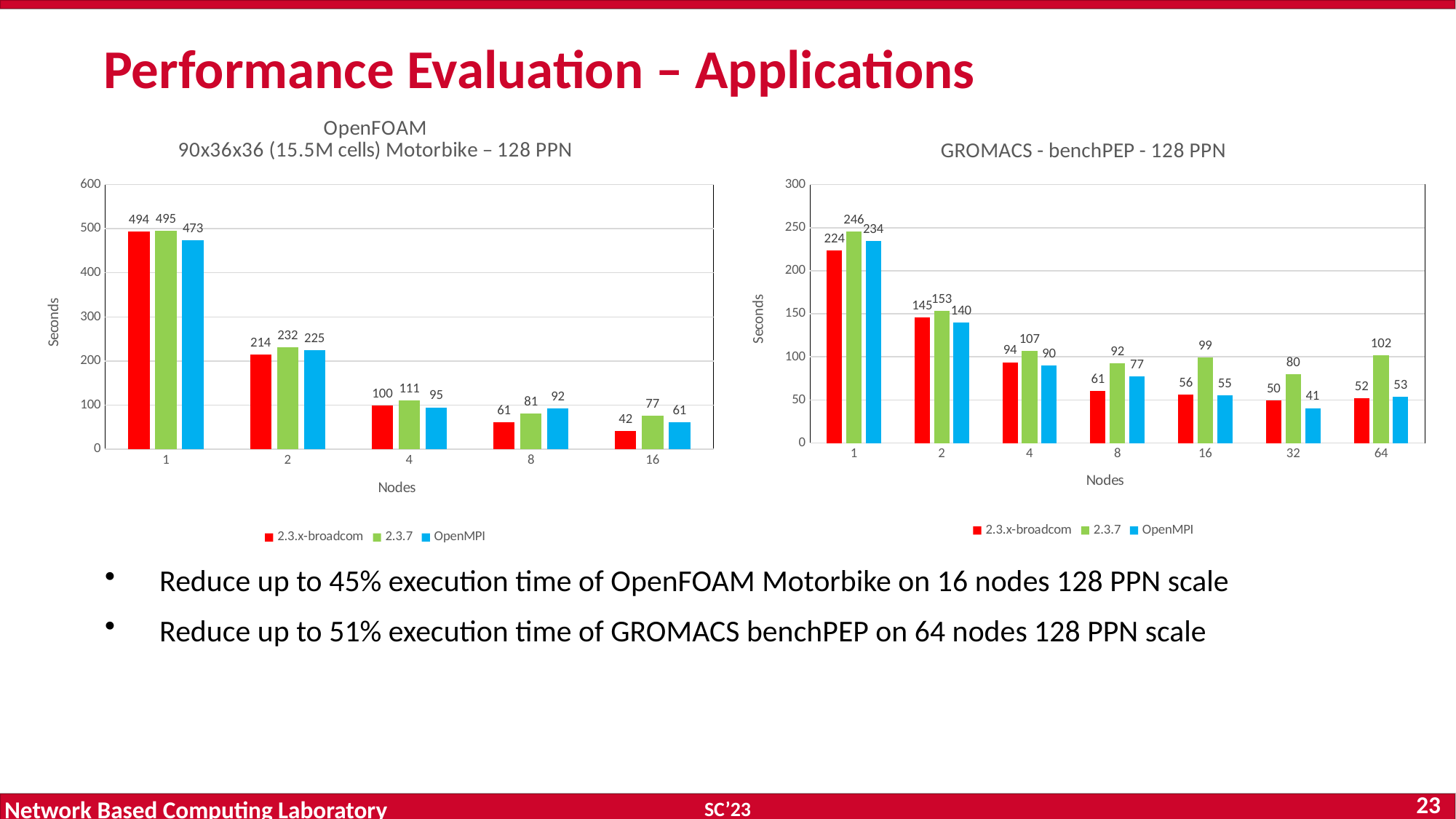
What kind of chart is the OpenFOAM chart? Bar chart In the OpenFOAM chart, what is the difference between the 2.3.7 and 2.3.x-broadcom values at 16 nodes? 35 In the OpenFOAM chart, what is the value for 2.3.x-broadcom at 16 nodes? 42 In the GROMACS chart, what is the value for OpenMPI at 32 nodes? 41 In the GROMACS chart, what is the difference between the 2.3.7 and OpenMPI values at 64 nodes? 49 In the GROMACS chart, which node count has the lowest value for 2.3.x-broadcom? 32 In the OpenFOAM chart, what is the value for OpenMPI at 1 node? 473 In the GROMACS chart, which is larger at 8 nodes: 2.3.x-broadcom or OpenMPI? OpenMPI In the OpenFOAM chart, which node count has the highest value for 2.3.7? 1 How many node counts are shown on the x axis of the GROMACS chart? 7 In the GROMACS chart, what is the value for 2.3.7 at 64 nodes? 102 How many series does the legend of the OpenFOAM chart list? 3